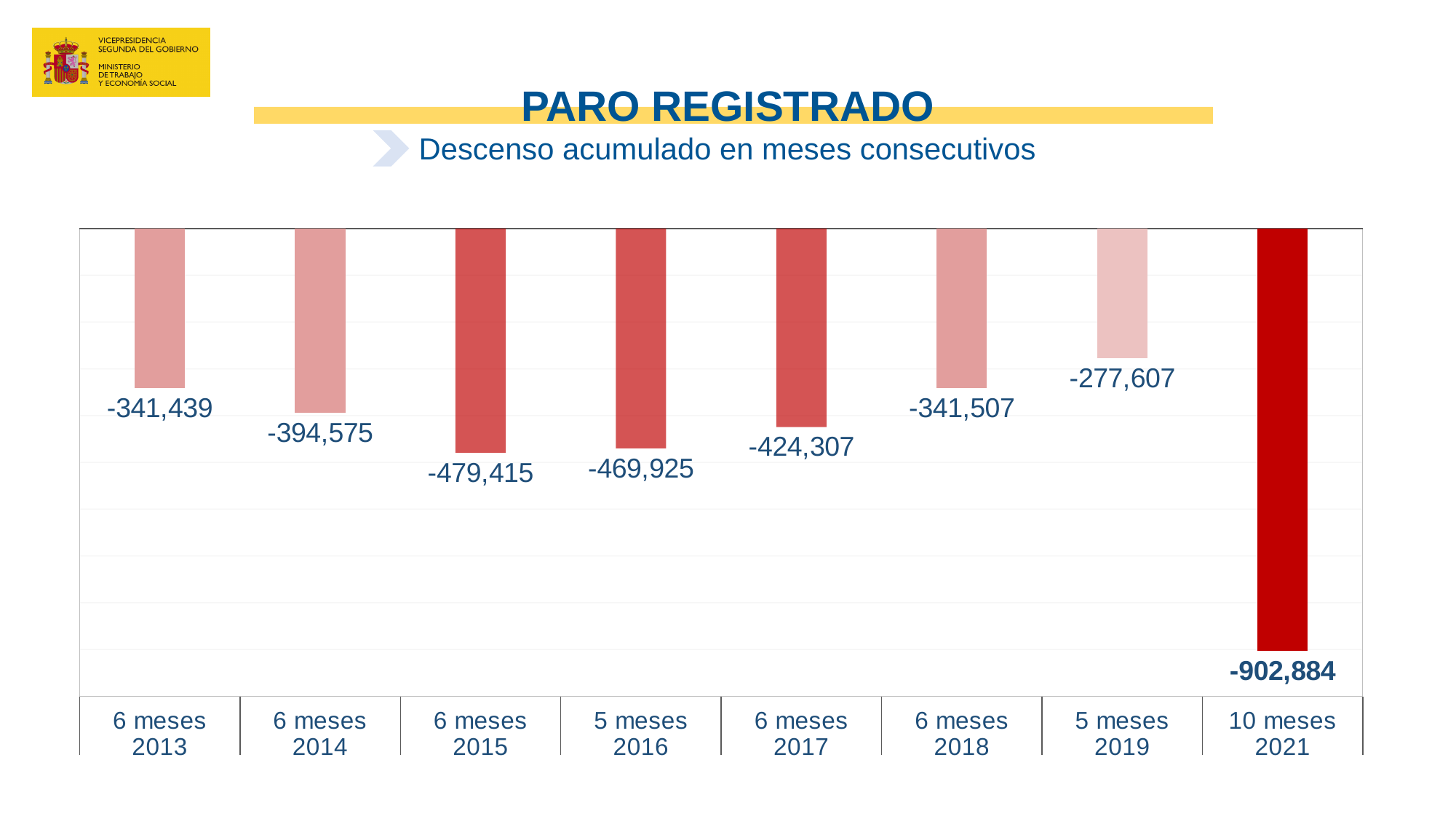
Which bar represents a larger decrease: 6 meses 2014 or 6 meses 2017? 6 meses 2017 Which category shows the smallest accumulated decrease (the shortest bar)? 5 meses 2019 What is the value shown for 10 meses 2021? -902,884 Which category shows the largest accumulated decrease (the longest bar)? 10 meses 2021 What is the value shown for 6 meses 2013? -341,439 What is the value shown for 5 meses 2019? -277,607 What is the value shown for 6 meses 2017? -424,307 What is the main title of the chart on the slide? PARO REGISTRADO How many bars (categories) are plotted in the chart? 8 What type of chart is shown on the slide? Bar chart By how much does the decrease for 6 meses 2015 exceed the decrease for 5 meses 2016 in absolute terms? 9,490 What is the difference in absolute value between the 10 meses 2021 bar and the 5 meses 2019 bar? 625,277